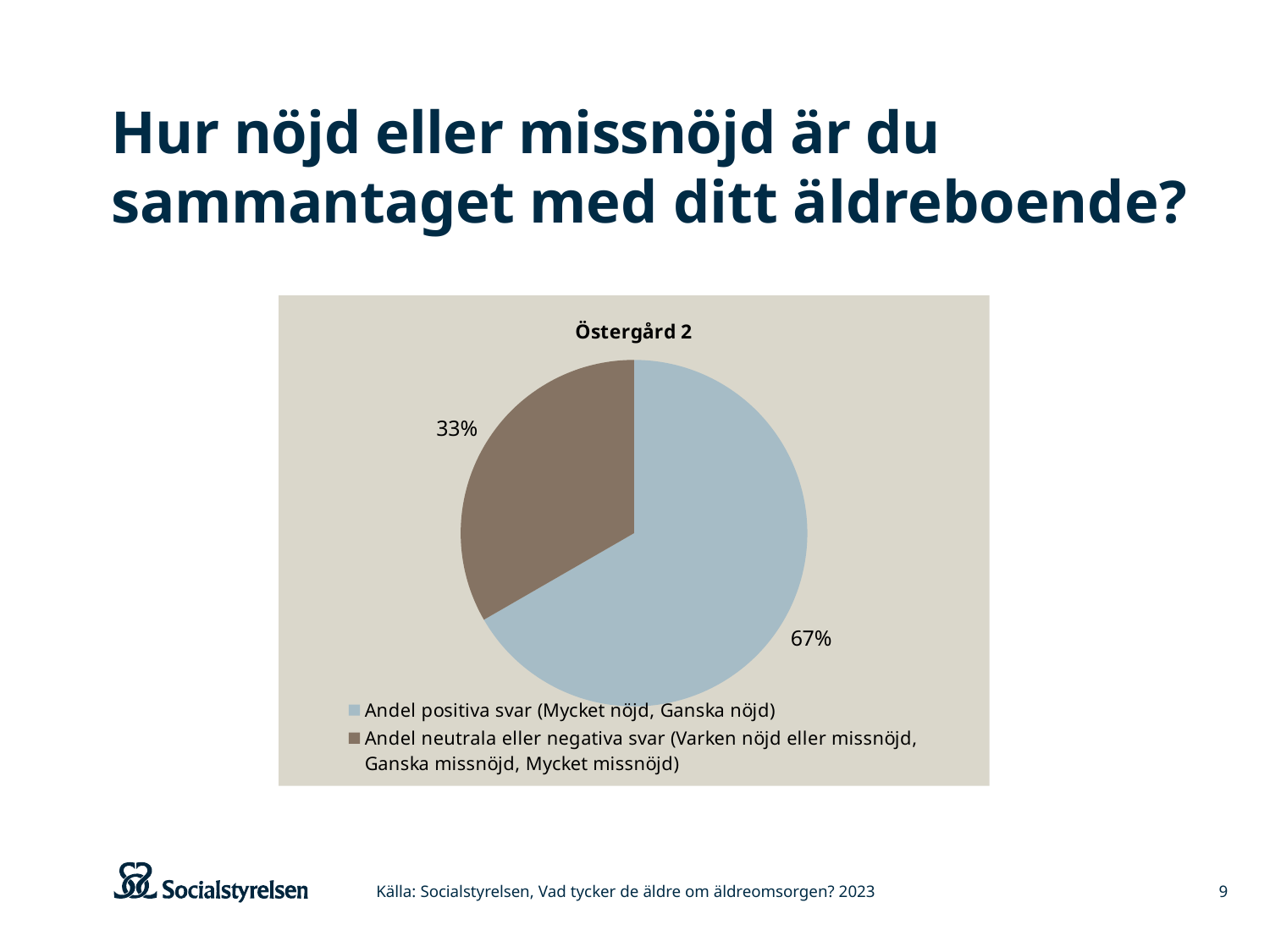
What share of the pie is 'Andel positiva svar (Mycket nöjd, Ganska nöjd)'? 67% How many entries does the legend list? 2 What colour is the slice for 'Andel positiva svar (Mycket nöjd, Ganska nöjd)'? light blue-grey How many slices does the pie chart have? 2 Which slice is the largest? Andel positiva svar (Mycket nöjd, Ganska nöjd) Which is larger: the share of positive answers or the share of neutral or negative answers? Andel positiva svar (Mycket nöjd, Ganska nöjd) Which slice is the smallest? Andel neutrala eller negativa svar (Varken nöjd eller missnöjd, Ganska missnöjd, Mycket missnöjd) What is the chart's title? Östergård 2 What is the difference in percentage points between the positive slice and the neutral/negative slice? 34 percentage points What kind of chart is shown on the slide? pie chart What share of the pie is 'Andel neutrala eller negativa svar (Varken nöjd eller missnöjd, Ganska missnöjd, Mycket missnöjd)'? 33%